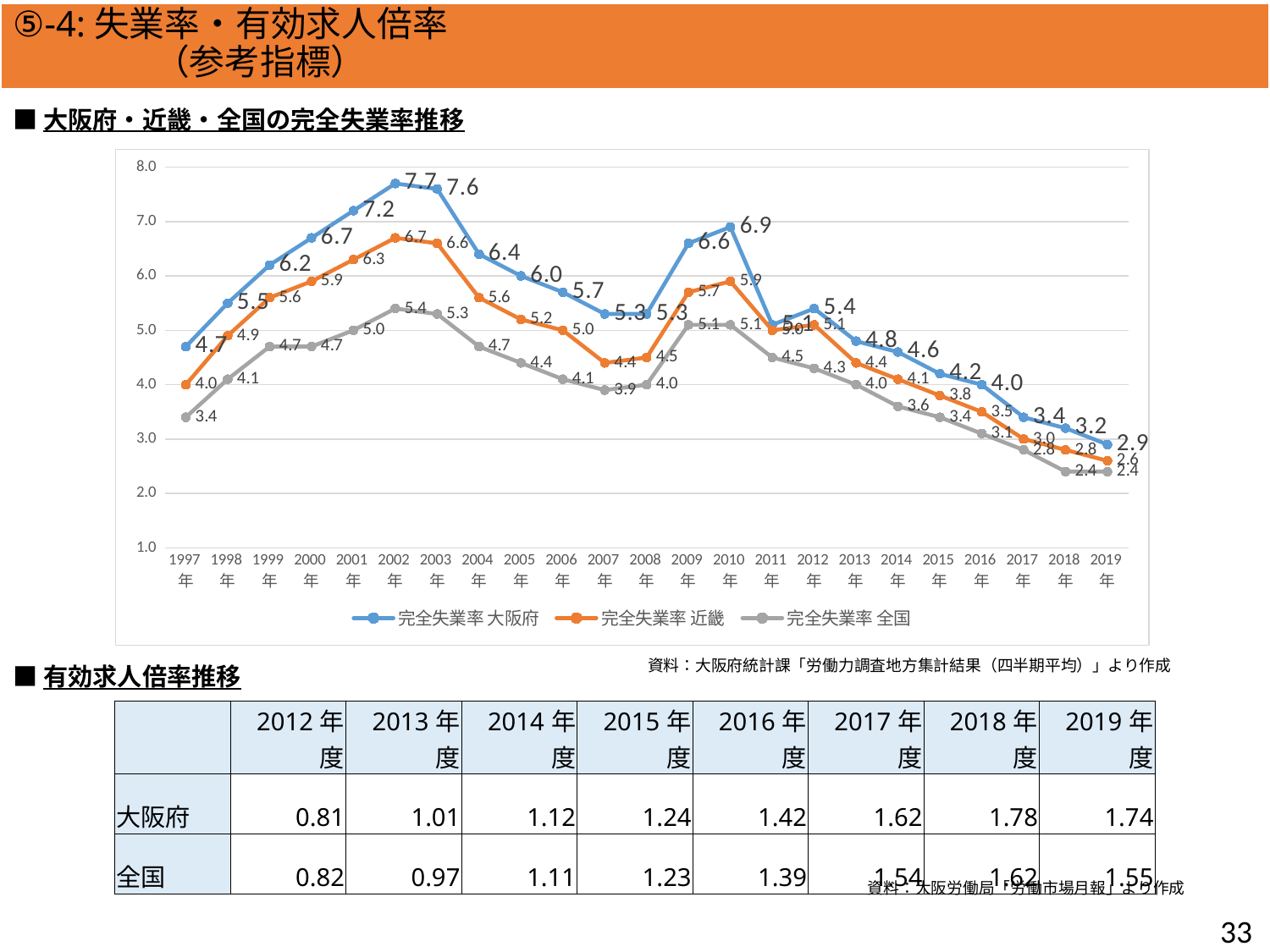
How many years are plotted along the x axis of the unemployment rate chart? 23 Which colour is used for the 完全失業率 全国 line? grey What kind of chart is used to show the unemployment rate trends for 大阪府, 近畿 and 全国? line chart From 2010年 to 2019年, does 完全失業率 大阪府 generally rise or fall? fall What is the 完全失業率 全国 value for 1997年? 3.4 How many series does the legend of the unemployment rate chart list? 3 What is the 完全失業率 近畿 value for 2010年? 5.9 In which year does 完全失業率 大阪府 reach its highest value? 2002年 What is the difference between 完全失業率 大阪府 and 完全失業率 全国 in 2002年? 2.3 Which is larger in 2009年, 完全失業率 大阪府 or 完全失業率 近畿? 完全失業率 大阪府 What is the 完全失業率 大阪府 value for 2002年? 7.7 In which year does 完全失業率 大阪府 reach its lowest value? 2019年